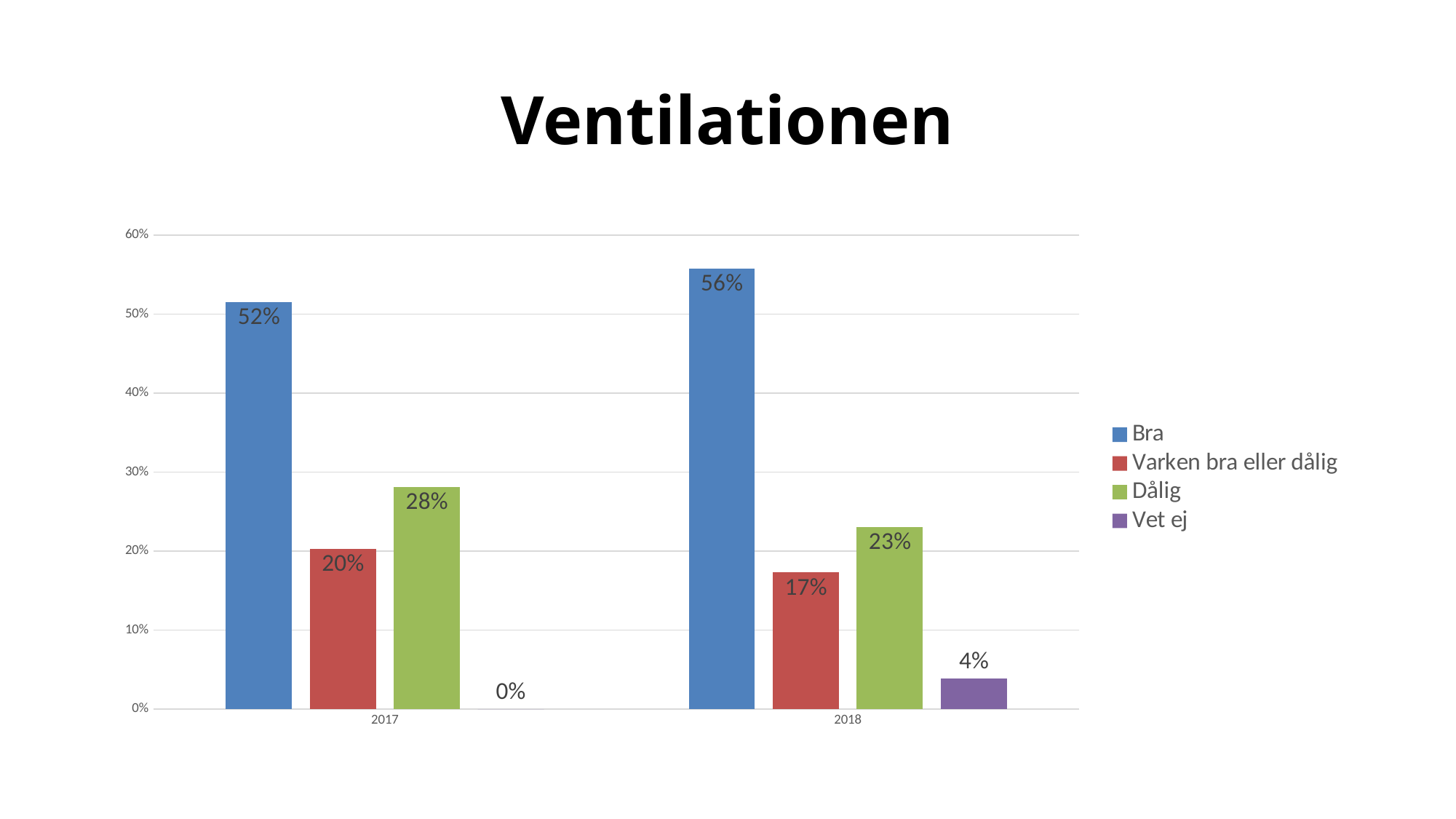
What is the value for Bra in 2017? 52% What is the title of the chart? Ventilationen Does the value for Bra rise or fall from 2017 to 2018? rise What kind of chart is shown on the slide? bar chart Which series has the lowest value in 2017? Vet ej What is the value for Dålig in 2017? 28% What is the value for Vet ej in 2018? 4% What is the value for Varken bra eller dålig in 2018? 17% Which is larger, Dålig in 2017 or Dålig in 2018? Dålig in 2017 What is the difference between the Bra values for 2018 and 2017? 4% How many series does the legend list? 4 Which series has the highest value in 2018? Bra